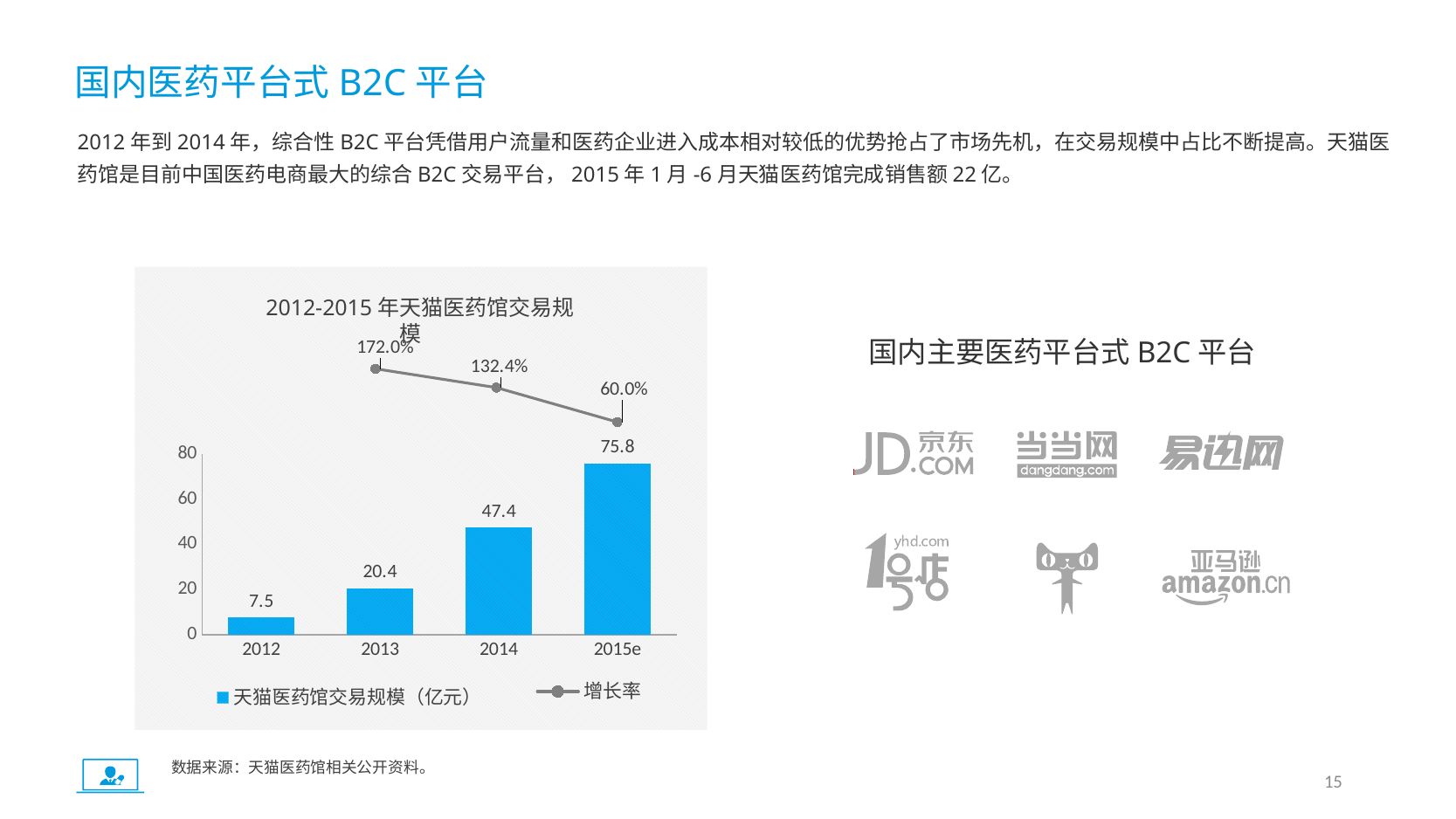
What is the 增长率 value for 2013? 172.0% What is the title of the chart? 2012-2015 年天猫医药馆交易规模 What is the 天猫医药馆交易规模 value for 2012? 7.5 Which year has the highest 天猫医药馆交易规模 value? 2015e What is the difference between the 天猫医药馆交易规模 values for 2015e and 2014? 28.4 Does the 增长率 line rise or fall from 2013 to 2015e? fall How many series does the chart legend list? 2 Which year has the lowest 增长率 value? 2015e Which is larger, the 天猫医药馆交易规模 value for 2013 or for 2014? 2014 How many years are shown on the x axis of the chart? 4 What is the 天猫医药馆交易规模 value for 2014? 47.4 What is the 增长率 value for 2015e? 60.0%